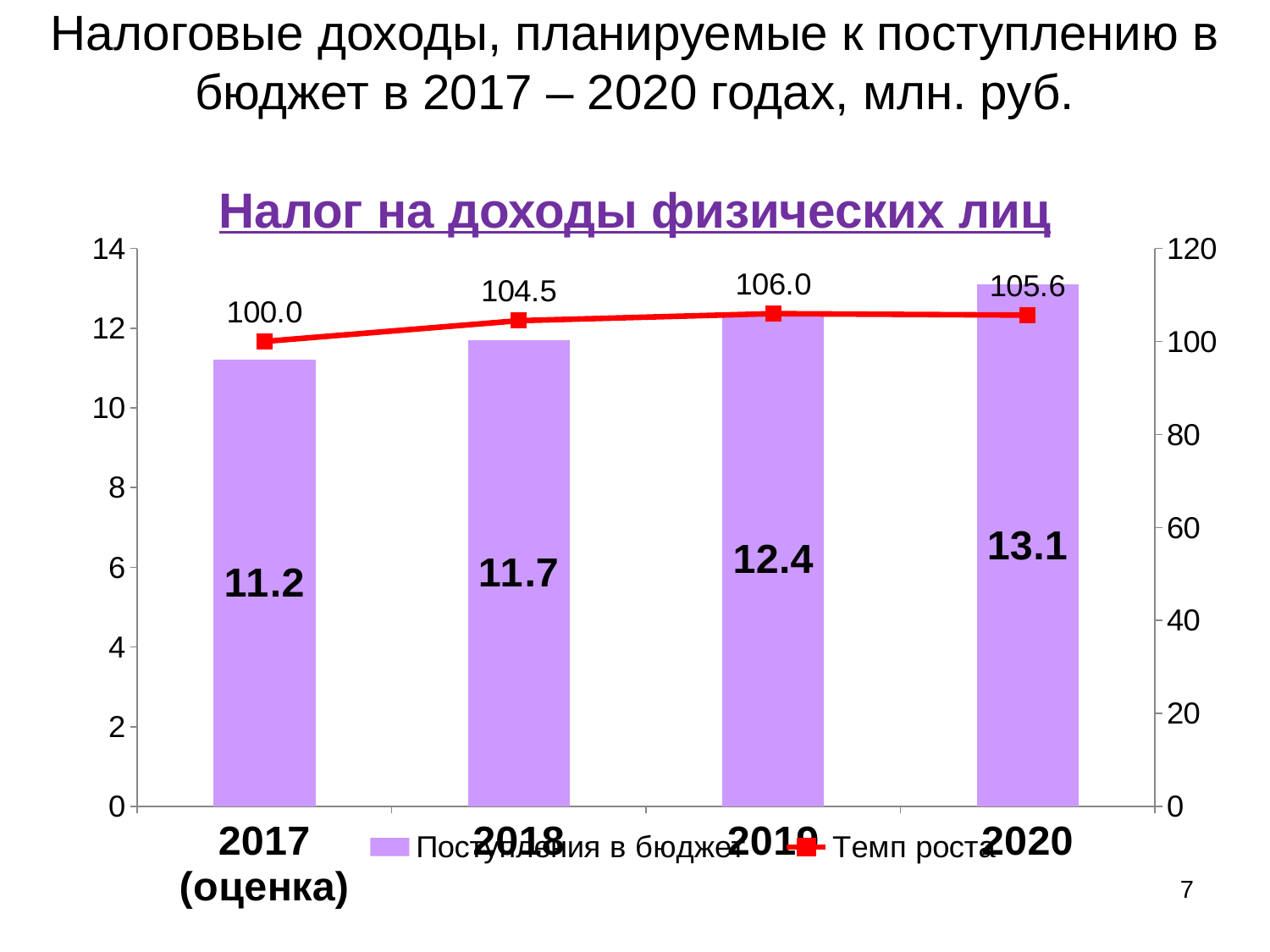
How many series does the legend list? 2 What is the value of 'Поступления в бюджет' for 2017 (оценка)? 11.2 What is the value of 'Темп роста' for 2019? 106.0 What is the value of 'Поступления в бюджет' for 2020? 13.1 Which year has the highest value of 'Поступления в бюджет'? 2020 What is the difference between 'Поступления в бюджет' in 2020 and in 2017 (оценка)? 1.9 What is the title of the chart? Налог на доходы физических лиц What is the value of 'Темп роста' for 2018? 104.5 Do the values of 'Поступления в бюджет' rise or fall from 2017 to 2020? rise How many years are shown on the x axis? 4 Which is larger, 'Темп роста' in 2019 or in 2020? 2019 Which year has the lowest value of 'Темп роста'? 2017 (оценка)